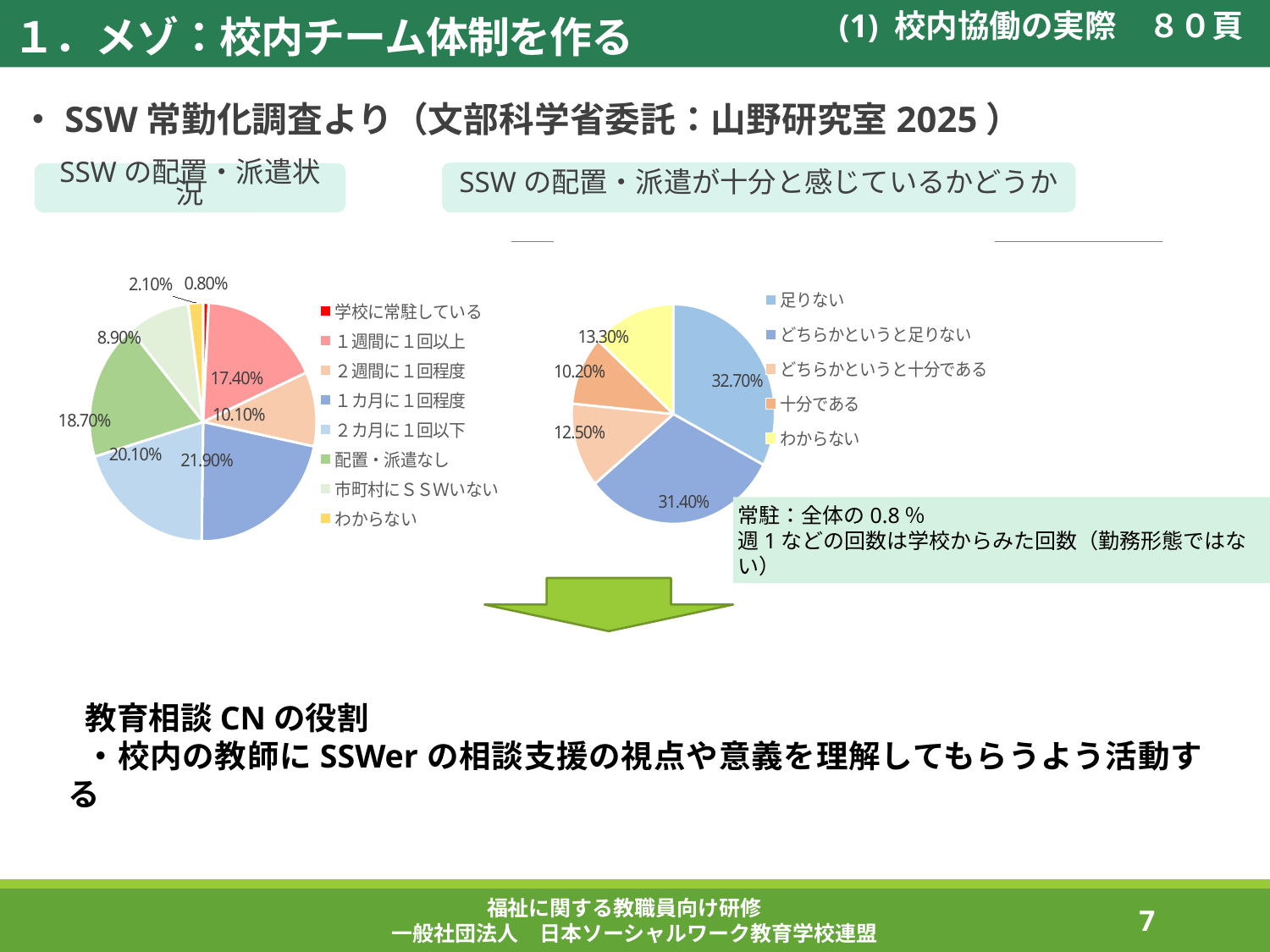
In the left pie chart (SSWの配置・派遣状況), what percentage is shown for 学校に常駐している? 0.80% In the right pie chart (SSWの配置・派遣が十分と感じているかどうか), which is larger: どちらかというと十分である or 十分である? どちらかというと十分である In the left pie chart (SSWの配置・派遣状況), which category has the smallest share? 学校に常駐している What type of chart is used for SSWの配置・派遣が十分と感じているかどうか? Pie chart In the left pie chart (SSWの配置・派遣状況), what is the difference between 配置・派遣なし and 市町村にSSWいない? 9.80% In the right pie chart (SSWの配置・派遣が十分と感じているかどうか), what percentage is shown for わからない? 13.30% In the left pie chart (SSWの配置・派遣状況), what percentage is shown for 1カ月に1回程度? 21.90% In the right pie chart (SSWの配置・派遣が十分と感じているかどうか), what percentage is shown for 足りない? 32.70% In the left pie chart (SSWの配置・派遣状況), which category has the largest share? 1カ月に1回程度 In the right pie chart (SSWの配置・派遣が十分と感じているかどうか), how many categories does the legend list? 5 In the left pie chart (SSWの配置・派遣状況), how many categories does the legend list? 8 In the right pie chart (SSWの配置・派遣が十分と感じているかどうか), which category has the smallest share? 十分である